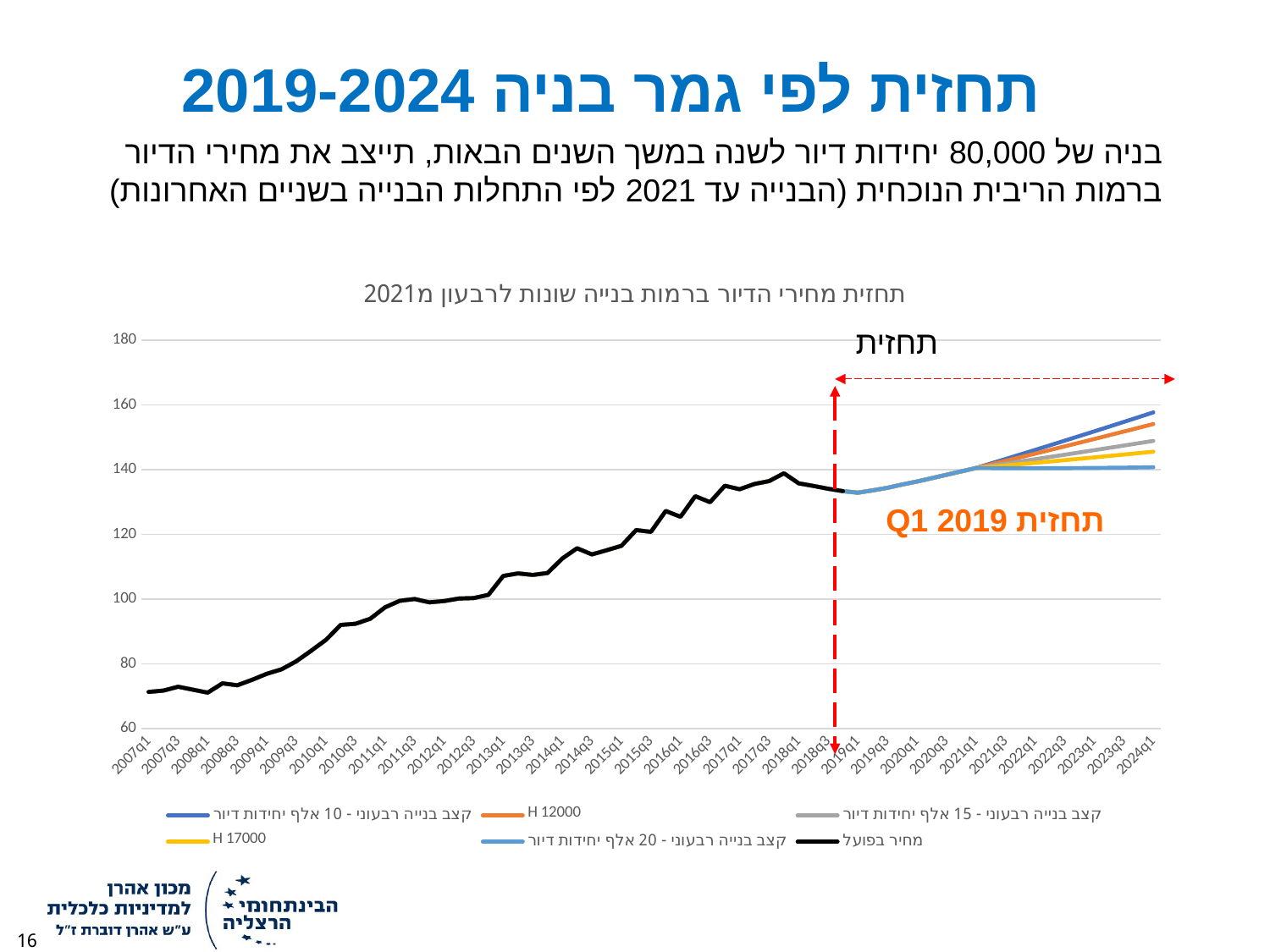
How many series does the chart legend list? 6 Is the value of the actual price (מחיר בפועל) at 2012q1 greater or less than 120? less Which forecast series has the lowest value at 2024q1? קצב בנייה רבעוני - 20 אלף יחידות דיור Which forecast series has the highest value at 2024q1? קצב בנייה רבעוני - 10 אלף יחידות דיור What is the title of the chart? תחזית מחירי הדיור ברמות בנייה שונות לרבעון מ2021 Is the value of the actual price (מחיר בפועל) at 2018q1 greater or less than 120? greater Which series is drawn with a black line? מחיר בפועל Is the value of the actual price (מחיר בפועל) at 2007q1 greater or less than 80? less What kind of chart is shown on the slide? line chart At 2024q1, which is larger: the value of 'H 12000' or the value of 'H 17000'? H 12000 Does the actual price (מחיר בפועל) series generally rise or fall from 2007q1 to 2018q1? rise